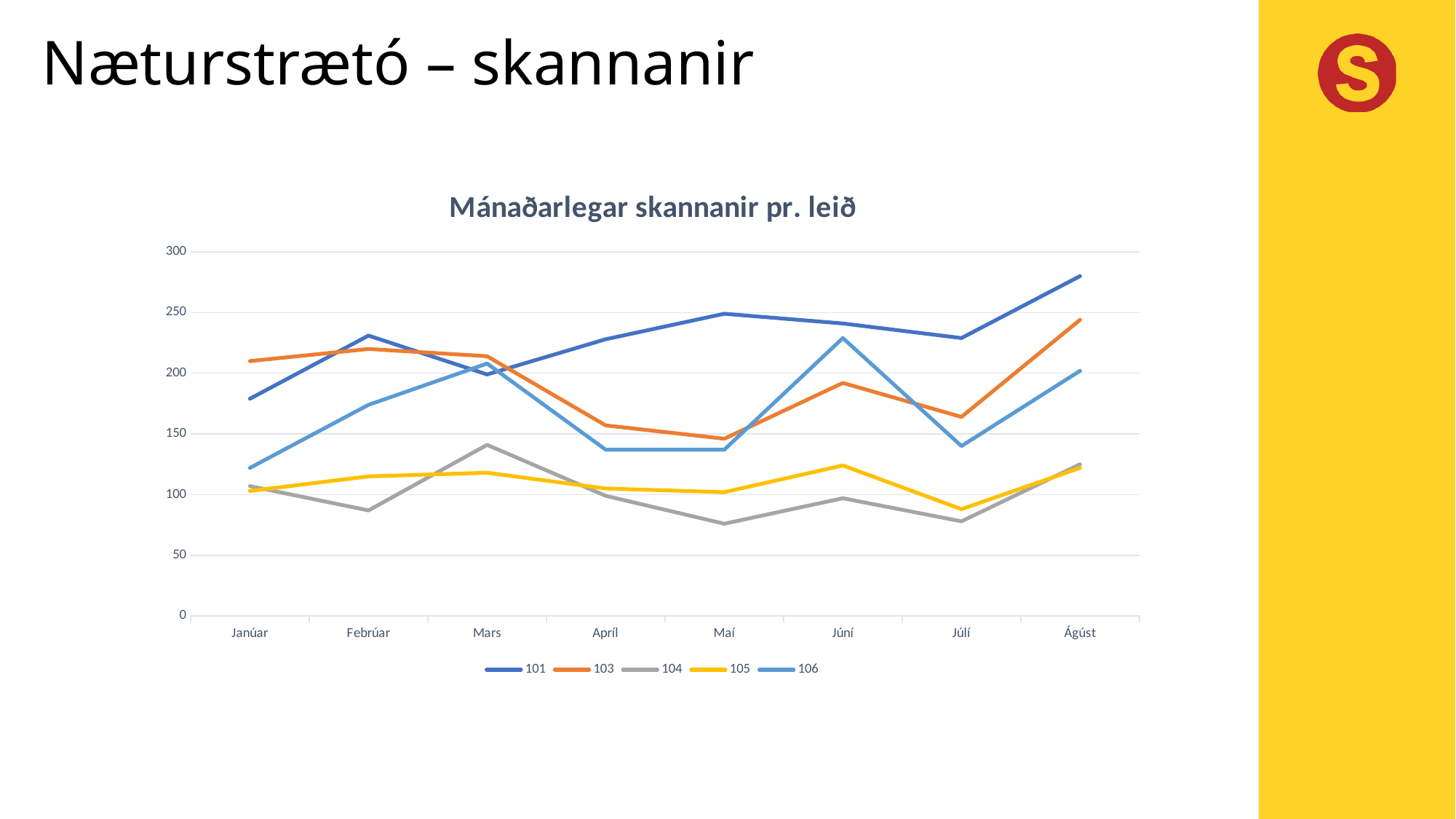
How many series does the legend list? 5 Is the value for series 103 in Maí greater or less than 150? less In which month does series 101 reach its highest value? Ágúst In which month does series 106 reach its highest value? Júní In Júní, which series has the larger value, 103 or 106? 106 Is the value for series 104 in Mars greater or less than 100? greater Is the value for series 101 in Ágúst greater or less than 250? greater What is the title of the chart? Mánaðarlegar skannanir pr. leið Does series 103 rise or fall from Mars to Maí? fall How many months are shown on the x axis? 8 In which month does series 106 have its lowest value? Janúar What kind of chart is shown on the slide? line chart